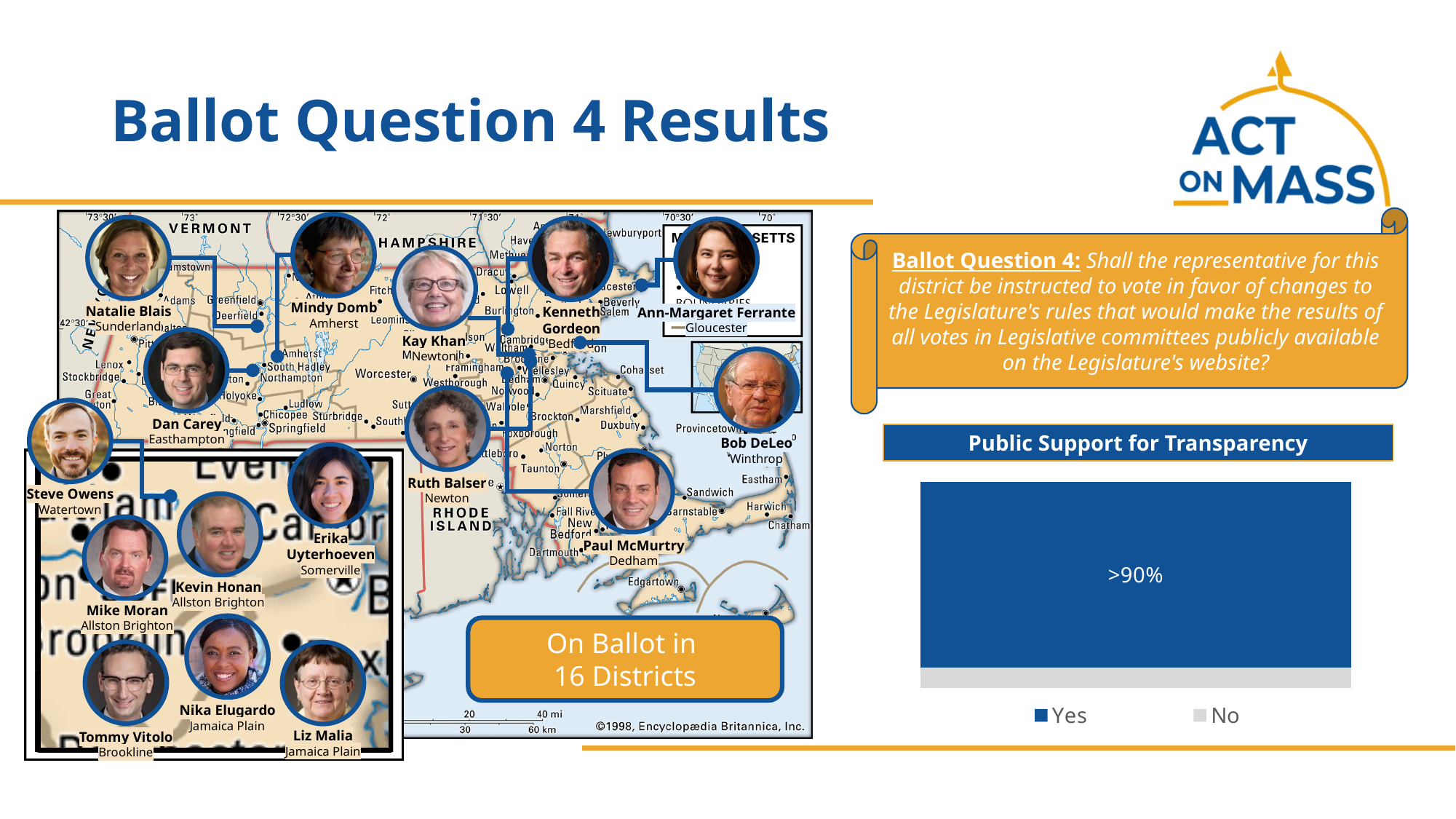
How many bars are plotted in the "Public Support for Transparency" chart? 1 In the "Public Support for Transparency" chart, which series takes up the larger share of the bar? Yes In the "Public Support for Transparency" chart, is the "Yes" segment larger or smaller than the "No" segment? larger What kind of chart is shown under the heading "Public Support for Transparency"? bar chart In the "Public Support for Transparency" chart, which series takes up the smaller share of the bar? No What is the title of the chart on the right side of the slide? Public Support for Transparency How many series does the legend of the "Public Support for Transparency" chart list? 2 What value is labelled on the "Yes" segment of the "Public Support for Transparency" chart? >90% What are the two series named in the legend of the "Public Support for Transparency" chart? Yes and No